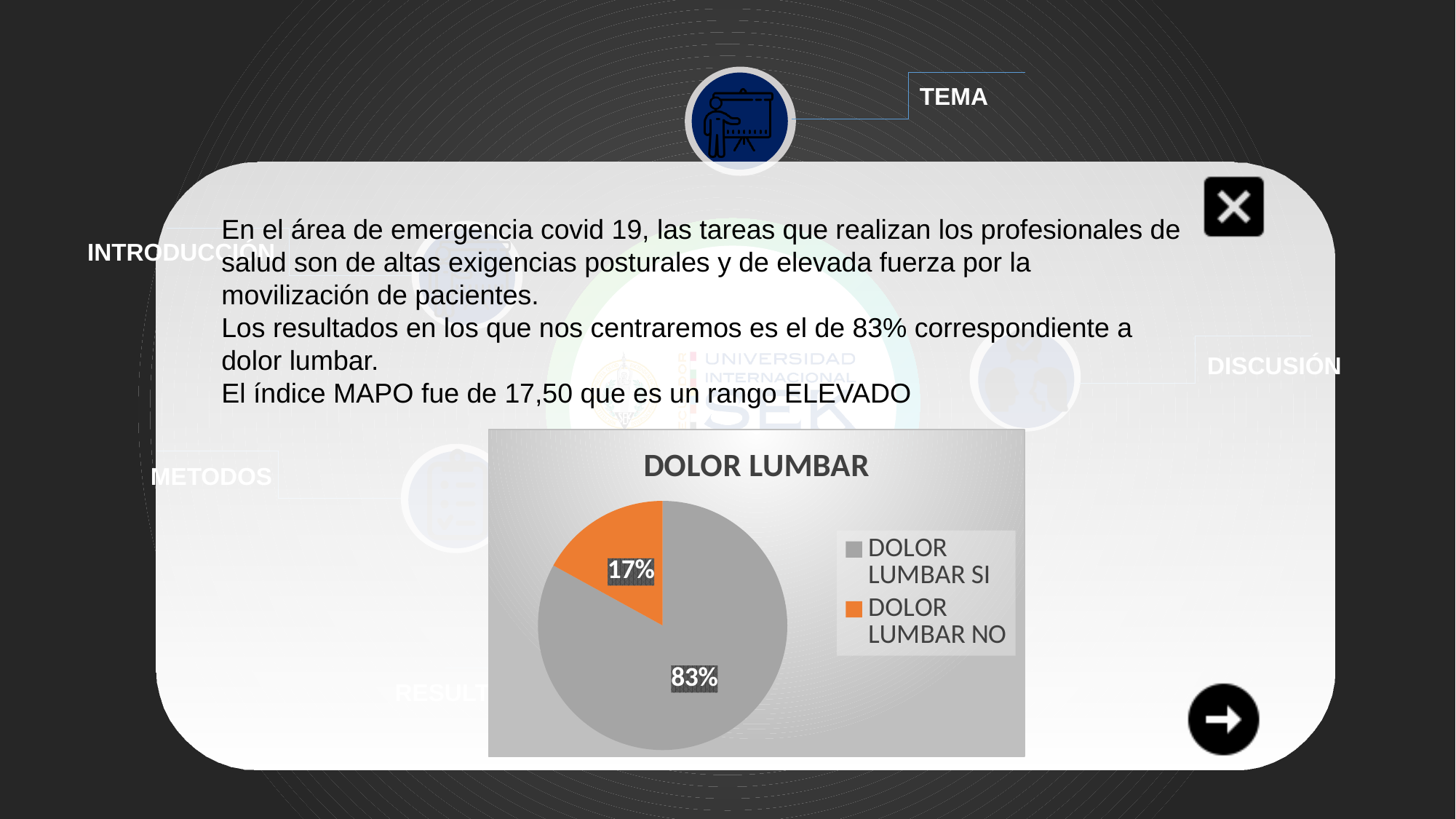
What colour is the DOLOR LUMBAR NO slice? orange What percentage is shown for DOLOR LUMBAR SI? 83% What percentage is shown for DOLOR LUMBAR NO? 17% What is the difference between the DOLOR LUMBAR SI and DOLOR LUMBAR NO percentages? 66% What share of the pie does DOLOR LUMBAR SI represent? 83% What kind of chart is shown on the slide? pie chart How many slices does the pie chart have? 2 Which is larger, DOLOR LUMBAR SI or DOLOR LUMBAR NO? DOLOR LUMBAR SI Which slice of the pie is the largest? DOLOR LUMBAR SI What is the title of the chart? DOLOR LUMBAR Which slice of the pie is the smallest? DOLOR LUMBAR NO How many entries does the legend list? 2